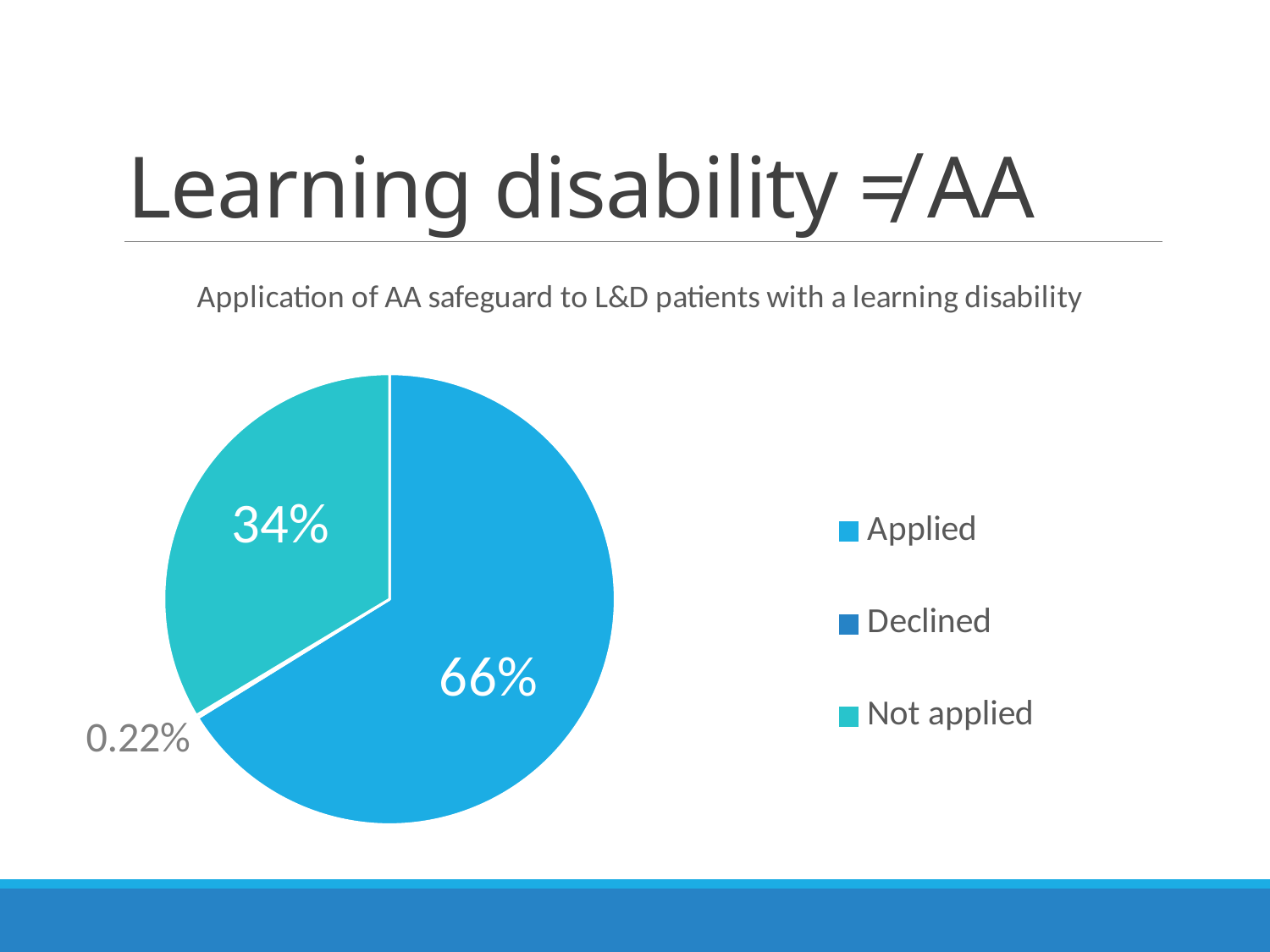
Which category has the smallest share of the pie? Declined What is the difference in percentage points between the Applied and Not applied shares? 32 What percentage of the pie is labelled for Not applied? 34% Which category has the largest share of the pie? Applied Which is larger, the share for Applied or the share for Not applied? Applied What percentage of the pie is labelled for Applied? 66% Which legend entry is shown in the lightest teal colour? Not applied What percentage of the pie is labelled for Declined? 0.22% How many slices does the pie chart have? 3 How many entries does the legend list? 3 What kind of chart is shown on the slide? pie chart What is the title of the chart? Application of AA safeguard to L&D patients with a learning disability